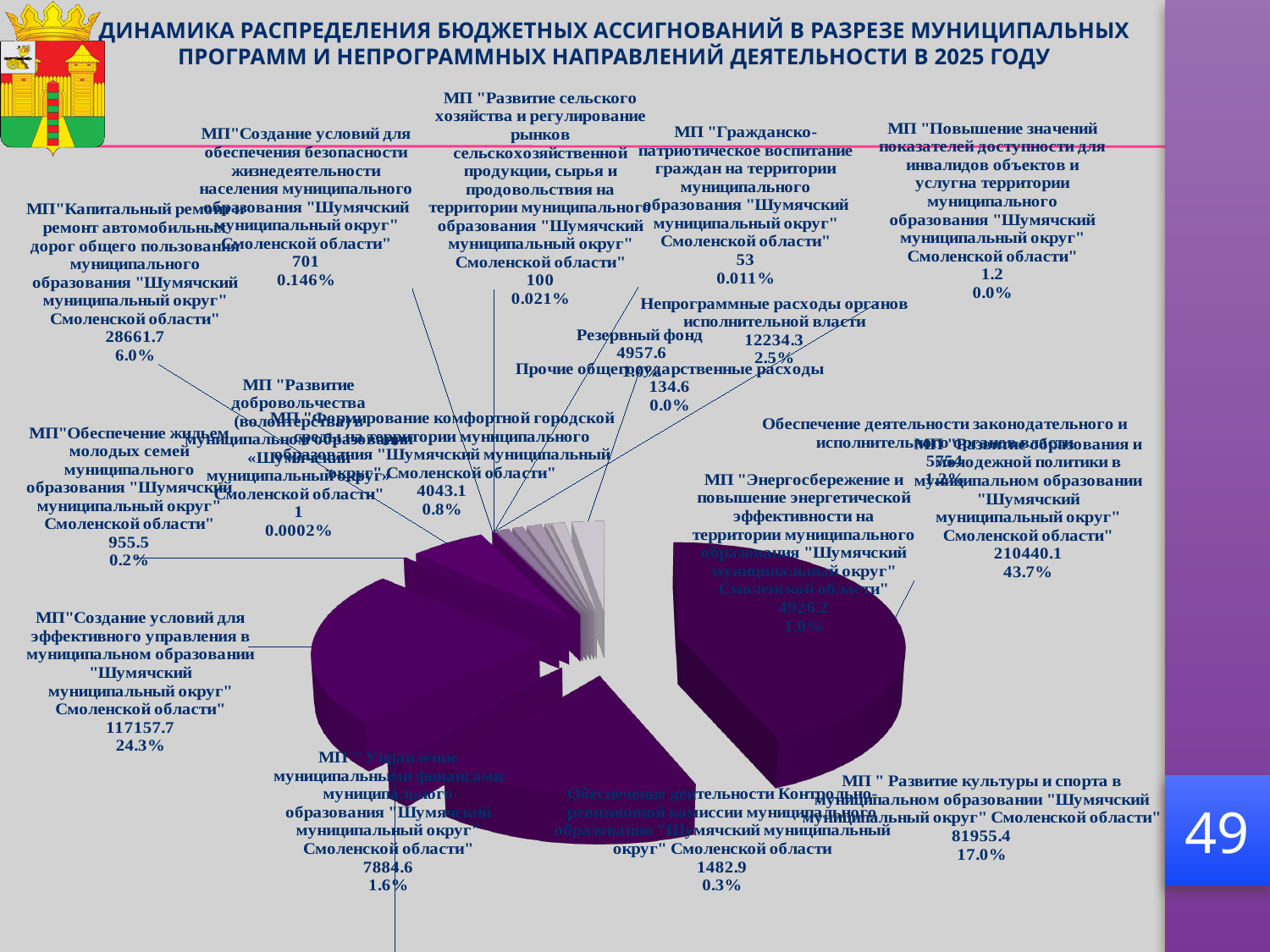
Which program has the largest share of the pie? МП "Развитие образования и молодежной политики" What percentage is shown for МП "Развитие культуры и спорта"? 17.0% What is the value shown for МП "Гражданско-патриотическое воспитание граждан"? 53 What is the value shown for МП "Создание условий для эффективного управления в муниципальном образовании"? 117157.7 What is the value shown for Резервный фонд? 4957.6 What share of the budget goes to МП "Развитие образования и молодежной политики"? 43.7% What percentage is shown for Непрограммные расходы органов исполнительной власти? 2.5% What kind of chart is shown on the slide? pie chart What percentage is shown for Обеспечение деятельности Контрольно-ревизионной комиссии? 0.3% Which item has the smallest value on the chart? МП "Развитие добровольчества (волонтерства)" Which is larger: the value for МП "Капитальный ремонт, ремонт автомобильных дорог" or for МП "Управление муниципальными финансами"? МП "Капитальный ремонт, ремонт автомобильных дорог" What is the difference between the values for МП "Развитие образования и молодежной политики" (210440.1) and МП "Создание условий для эффективного управления" (117157.7)? 93282.4